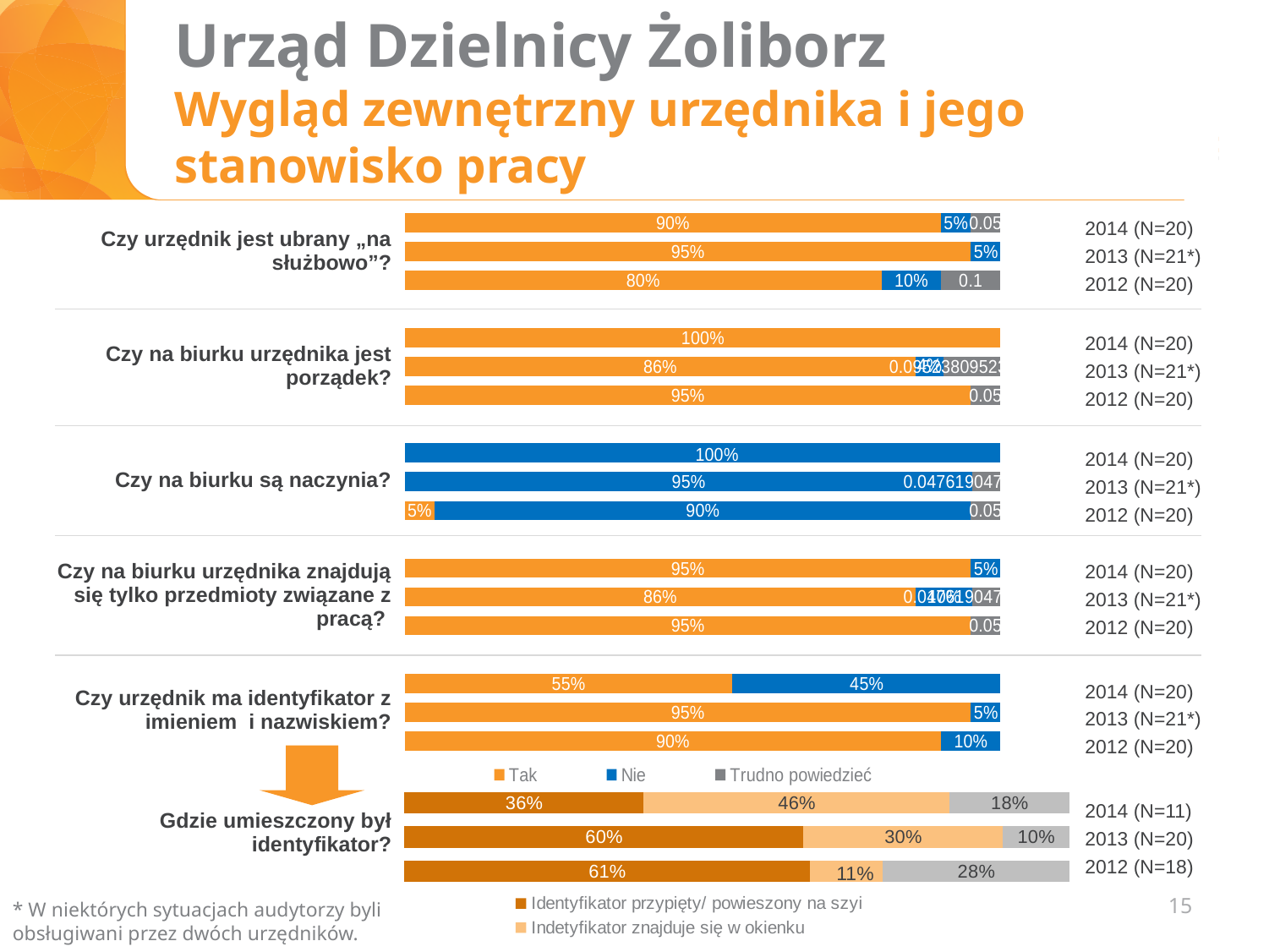
In the chart "Gdzie umieszczony był identyfikator?", what is the value for "Indetyfikator znajduje się w okienku" in 2014 (N=11)? 46% In the chart "Gdzie umieszczony był identyfikator?", is the "Identyfikator przypięty/ powieszony na szyi" value larger in 2012 (N=18) or in 2014 (N=11)? 2012 (N=18) In the chart "Gdzie umieszczony był identyfikator?", what is the value for "Identyfikator przypięty/ powieszony na szyi" in 2013 (N=20)? 60% In the chart "Czy urzędnik ma identyfikator z imieniem i nazwiskiem?", what percentage answered "Nie" in 2014 (N=20)? 45% In the chart "Czy na biurku są naczynia?", what percentage answered "Tak" in 2012 (N=20)? 5% In the chart "Czy urzędnik jest ubrany „na służbowo”?", what percentage answered "Tak" in 2014 (N=20)? 90% In the chart "Czy na biurku urzędnika jest porządek?", what is the "Tak" value for 2014 (N=20)? 100% In the chart "Czy urzędnik ma identyfikator z imieniem i nazwiskiem?", what is the difference between the "Tak" share in 2013 (N=21*) and in 2014 (N=20)? 40% In the chart "Czy urzędnik jest ubrany „na służbowo”?", which year has the highest "Tak" share? 2013 (N=21*) In the chart "Czy urzędnik ma identyfikator z imieniem i nazwiskiem?", which year has the lowest "Tak" share? 2014 (N=20) In the chart "Czy urzędnik jest ubrany „na służbowo”?", what percentage answered "Nie" in 2012 (N=20)? 10% How many entries does the legend above the "Gdzie umieszczony był identyfikator?" chart list (Tak / Nie / Trudno powiedzieć)? 3